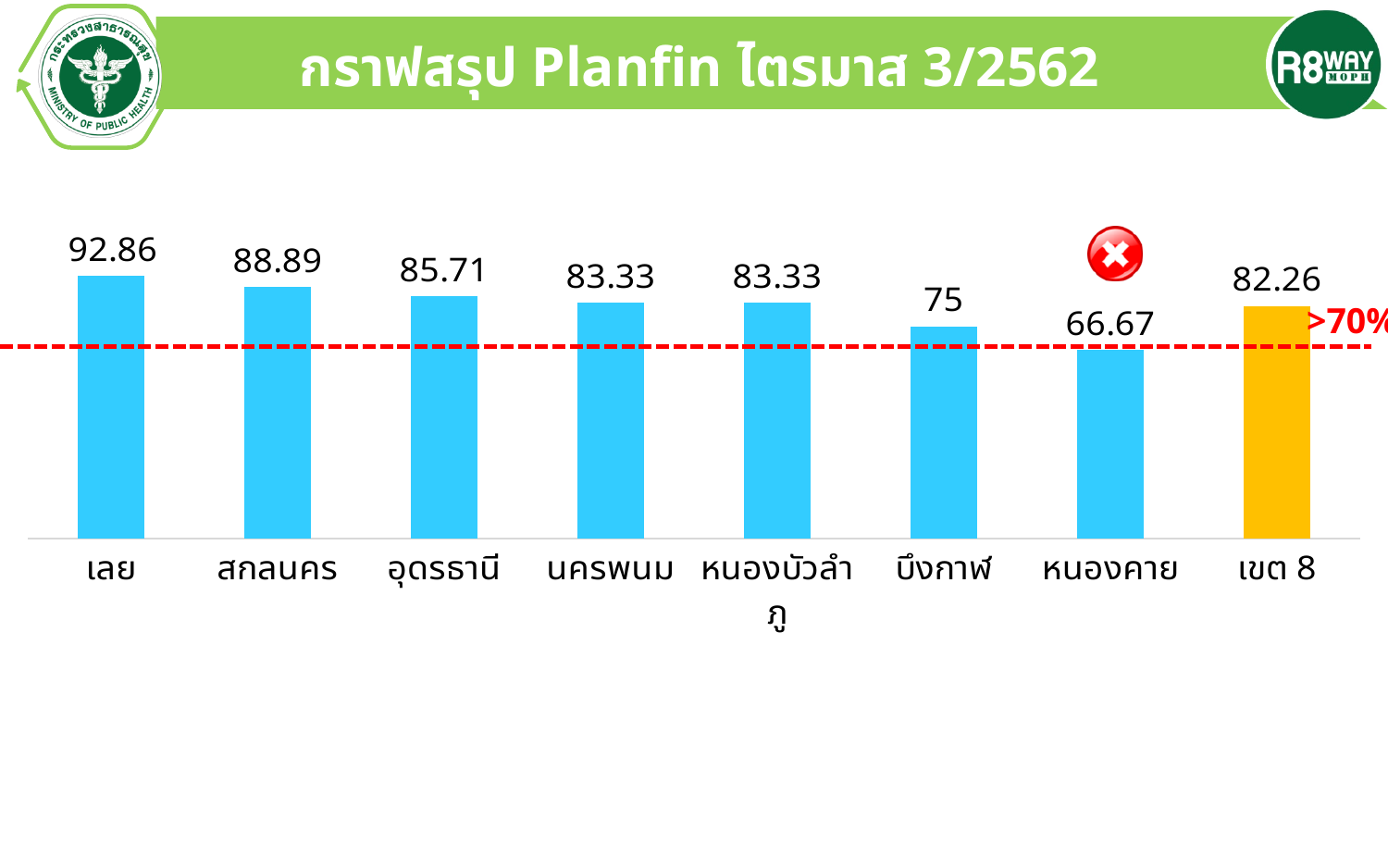
What is the value for เขต 8? 82.26 What is the value for หนองคาย? 66.67 How many categories are shown on the x axis? 8 Which category has the highest value? เลย Which is larger, the value for อุดรธานี or the value for นครพนม? อุดรธานี What threshold does the red dashed line on the chart mark? >70% Which category has the lowest value? หนองคาย What is the value for เลย? 92.86 What is the difference between the values for เลย and สกลนคร? 3.97 What is the value for บึงกาฬ? 75 What is the difference between the values for บึงกาฬ and หนองคาย? 8.33 What kind of chart is shown on the slide? bar chart